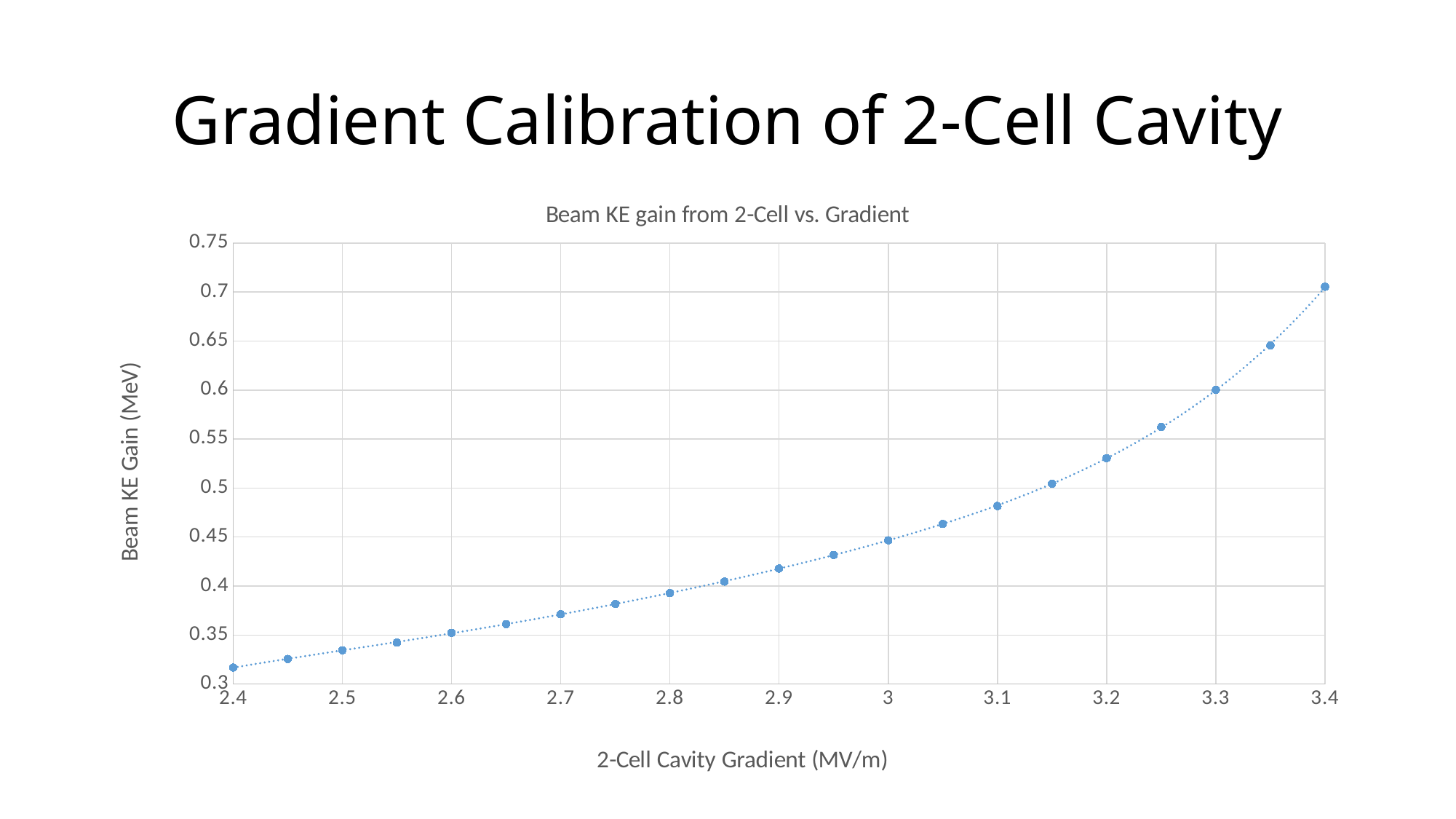
Is the Beam KE Gain at a gradient of 3.4 greater or less than 0.65? greater Is the Beam KE Gain at a gradient of 2.4 greater or less than 0.35? less Is the Beam KE Gain at a gradient of 2.6 greater or less than 0.4? less Which has the larger Beam KE Gain, a gradient of 3.1 or a gradient of 2.9? 3.1 At which gradient is the Beam KE Gain highest? 3.4 At which gradient is the Beam KE Gain lowest? 2.4 What is the title of the chart? Beam KE gain from 2-Cell vs. Gradient Do the Beam KE Gain values rise or fall as the gradient increases from 2.4 to 3.4 MV/m? rise How many data points are plotted on the chart? 21 What kind of chart is shown on the slide? line chart What is the label of the vertical axis? Beam KE Gain (MeV)